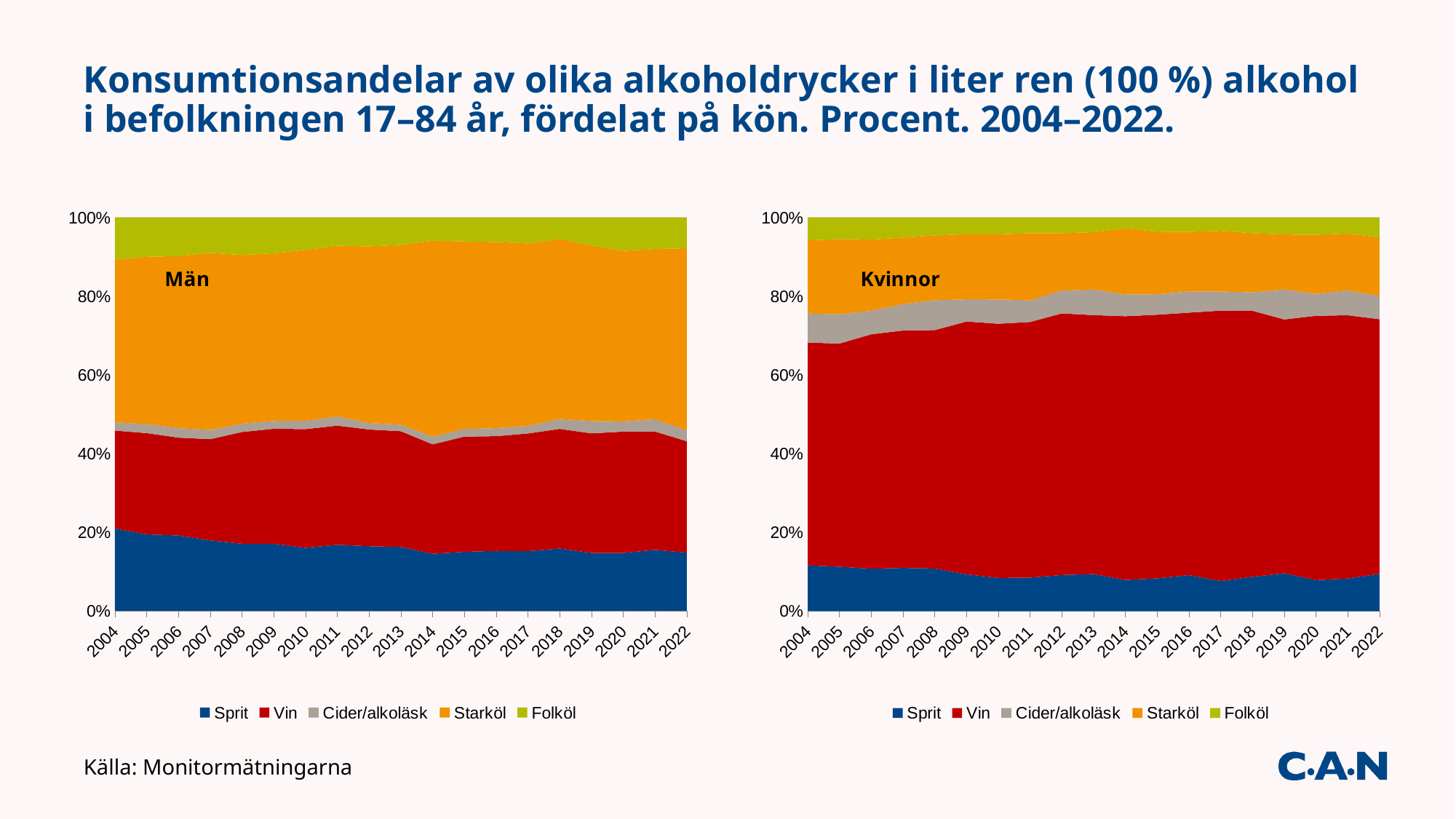
In the "Män" chart, is the share for Sprit in 2022 greater or less than 20%? less How many series does the legend of the "Kvinnor" chart list? 5 In 2022, is the share for Vin larger in the "Män" chart or the "Kvinnor" chart? Kvinnor In 2022, is the share for Starköl larger in the "Män" chart or the "Kvinnor" chart? Män In the "Män" chart, is the share for Starköl in 2004 greater or less than 30%? greater How many years are shown on the x axis of the "Män" chart? 19 In the "Män" chart, which series is shown in orange? Starköl What kind of chart is the "Män" chart on the left? Stacked area chart In the "Kvinnor" chart, does the share for Vin rise or fall from 2004 to 2022? Rise In the "Kvinnor" chart, which series is shown in dark blue at the bottom of the stack? Sprit In the "Män" chart, does the share for Sprit rise or fall from 2004 to 2022? Fall In the "Kvinnor" chart, is the share for Vin in 2022 greater or less than 60%? greater